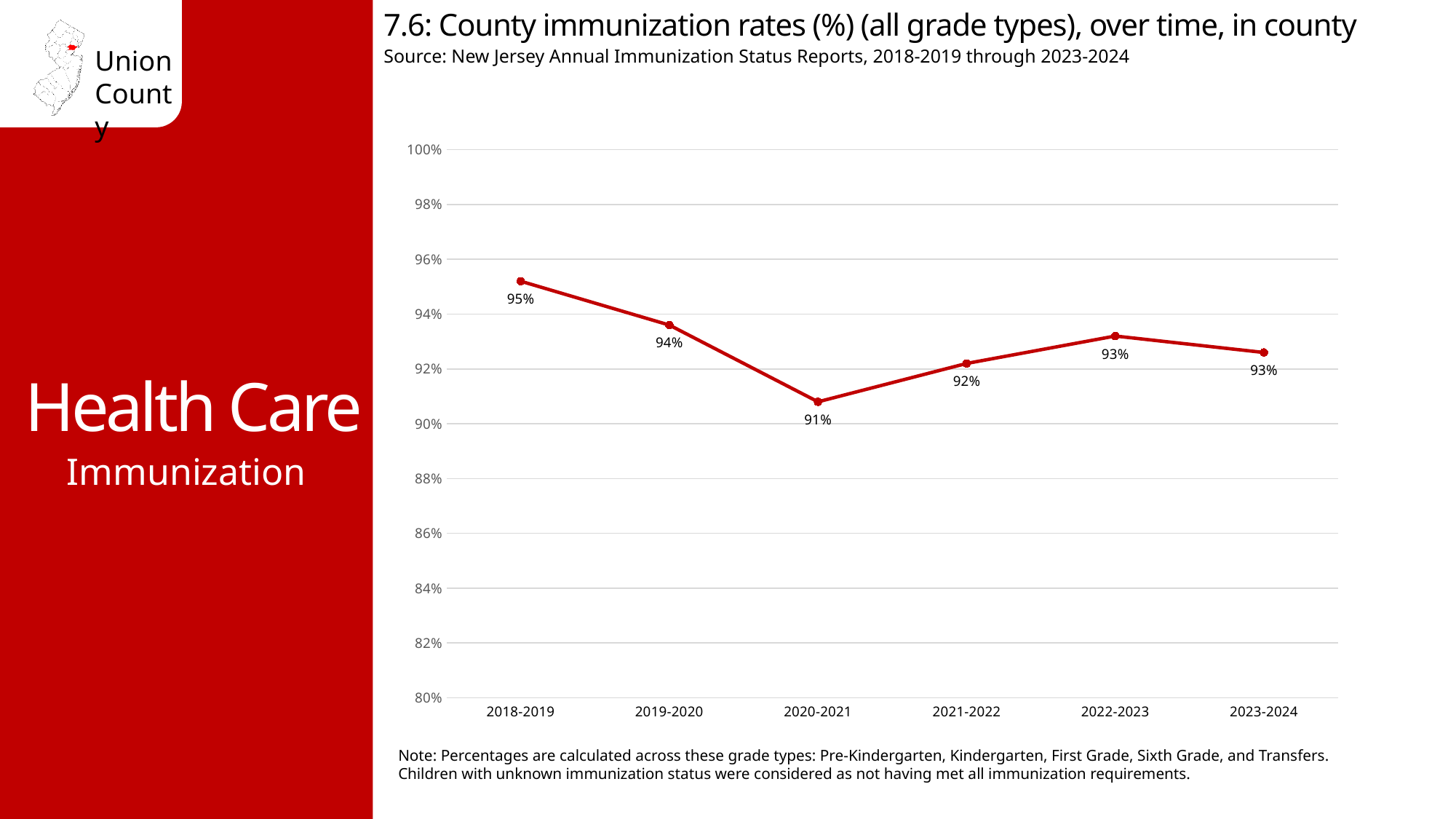
Which is larger, the immunization rate for 2019-2020 or for 2021-2022? 2019-2020 What is the county immunization rate for 2018-2019? 95% Does the immunization rate rise or fall from 2018-2019 to 2020-2021? Fall What is the county immunization rate for 2019-2020? 94% Is the value for 2020-2021 greater or less than 90%? greater What kind of chart is shown on the slide? Line chart How many school years are plotted on the chart? 6 Which school year has the highest immunization rate? 2018-2019 What is the difference in percentage points between the 2018-2019 rate and the 2020-2021 rate? 4 percentage points What is the county immunization rate for 2020-2021? 91% Which school year has the lowest immunization rate? 2020-2021 What is the county immunization rate for 2021-2022? 92%